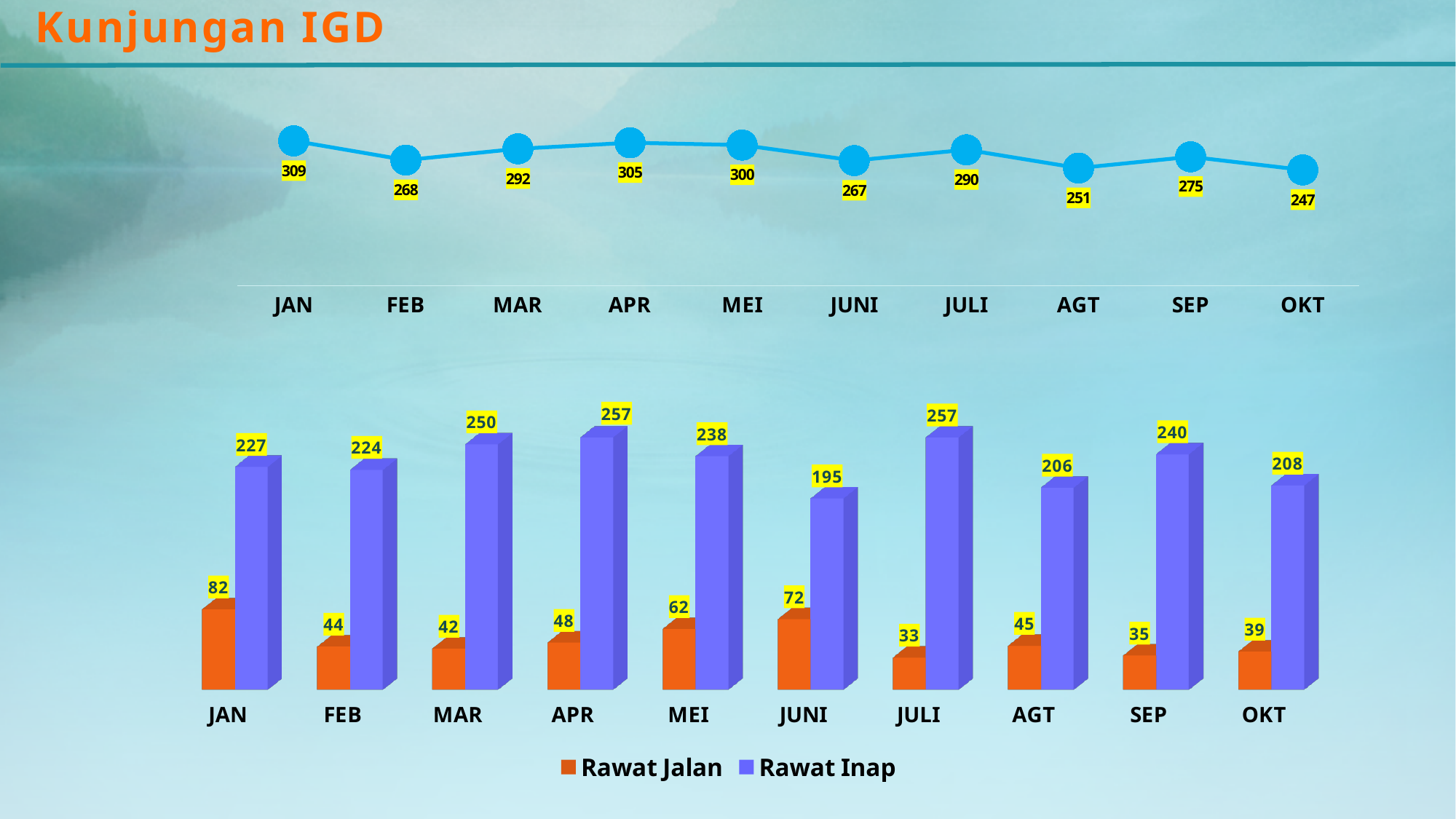
In the bar chart at the bottom of the slide, what is the Rawat Inap value for JUNI? 195 What type of chart is shown at the bottom of the slide? Bar chart In the line chart at the top of the slide, which month has the lowest value? OKT In the bar chart at the bottom of the slide, what is the difference between the Rawat Inap and Rawat Jalan values for MEI? 176 In the line chart at the top of the slide, which month has the highest value? JAN In the line chart at the top of the slide, what is the difference between the values for APR and AGT? 54 In the bar chart at the bottom of the slide, what is the Rawat Jalan value for JULI? 33 In the line chart at the top of the slide, what is the value for JAN? 309 In the bar chart at the bottom of the slide, which month has the highest Rawat Jalan value? JAN In the bar chart at the bottom of the slide, how many series does the legend list? 2 In the bar chart at the bottom of the slide, which month has the lowest Rawat Inap value? JUNI In the line chart at the top of the slide, how many months are plotted? 10